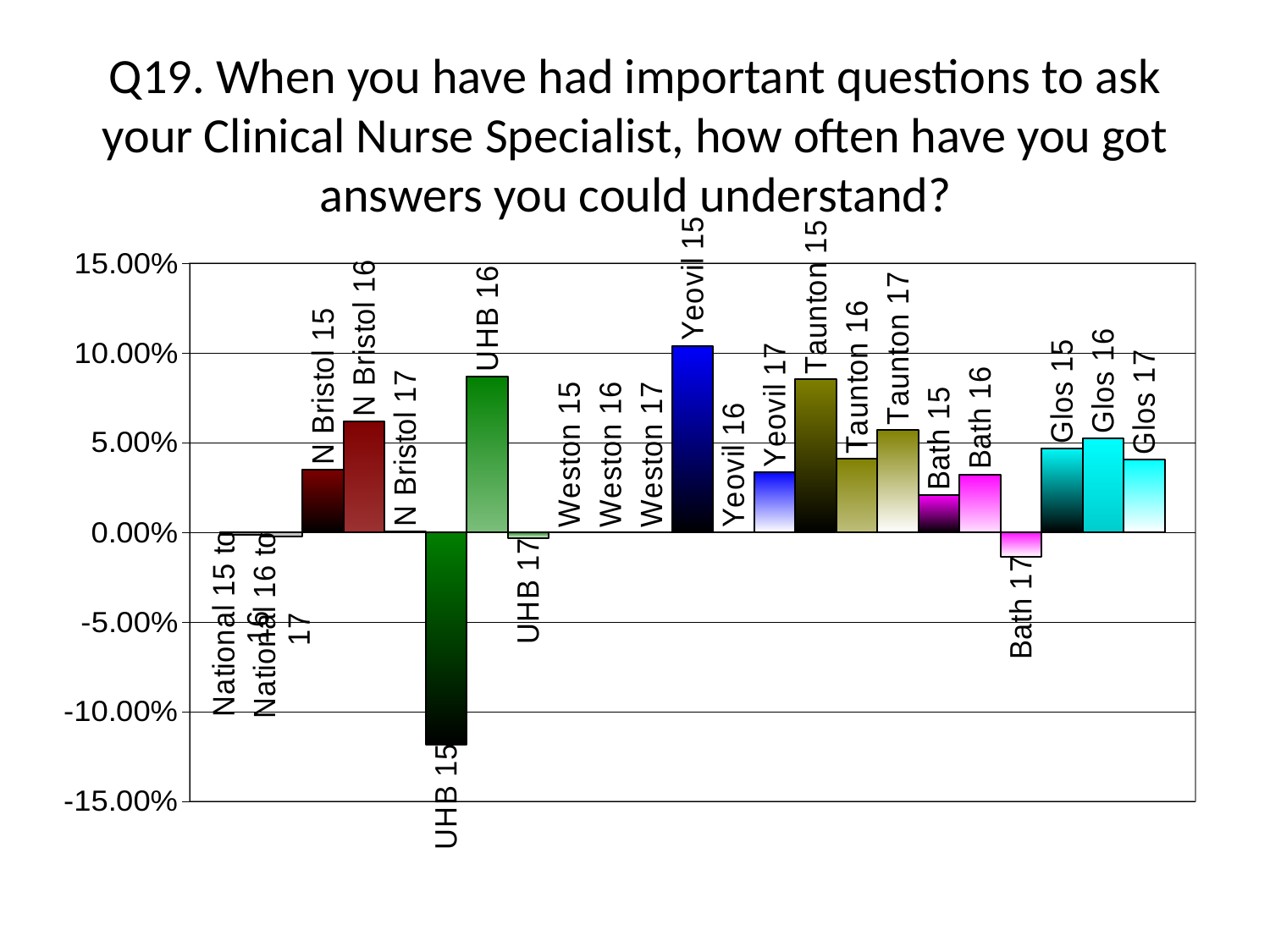
Is the value for Yeovil 15 greater or less than 10.00%? greater Is the value for UHB 15 greater or less than -10.00%? less Is the value for Bath 15 greater or less than 5.00%? less What is the title of the chart? Q19. When you have had important questions to ask your Clinical Nurse Specialist, how often have you got answers you could understand? Which is larger, the value for N Bristol 16 or N Bristol 15? N Bristol 16 Which is larger, the value for Bath 16 or Bath 17? Bath 16 Which is larger, the value for Taunton 15 or Taunton 16? Taunton 15 What kind of chart is shown on the slide? bar chart Which category has the highest value? Yeovil 15 Which category has the lowest value? UHB 15